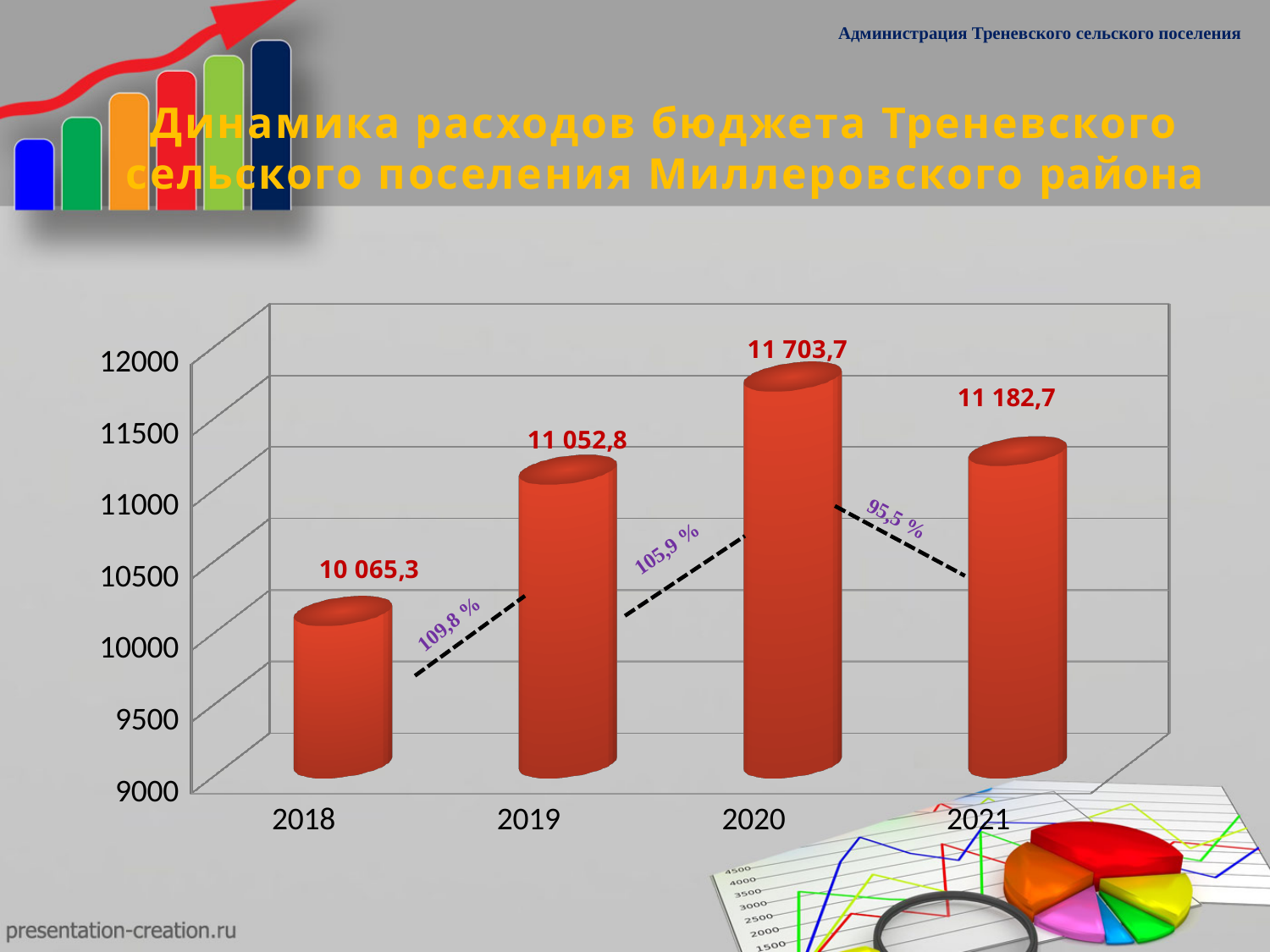
What is the value for 2021? 11 182,7 What is the value for 2018? 10 065,3 What is the difference between the values for 2020 and 2021? 521 Is the value for 2018 greater or less than 10500? less How many years are shown on the x axis? 4 What is the value for 2020? 11 703,7 Which year has the lowest value? 2018 Which year has the highest value? 2020 What percentage is shown on the dashed line between 2020 and 2021? 95,5 % What is the difference between the values for 2019 and 2018? 987,5 Which is larger, the value for 2019 or the value for 2021? 2021 What kind of chart is shown on the slide? bar chart